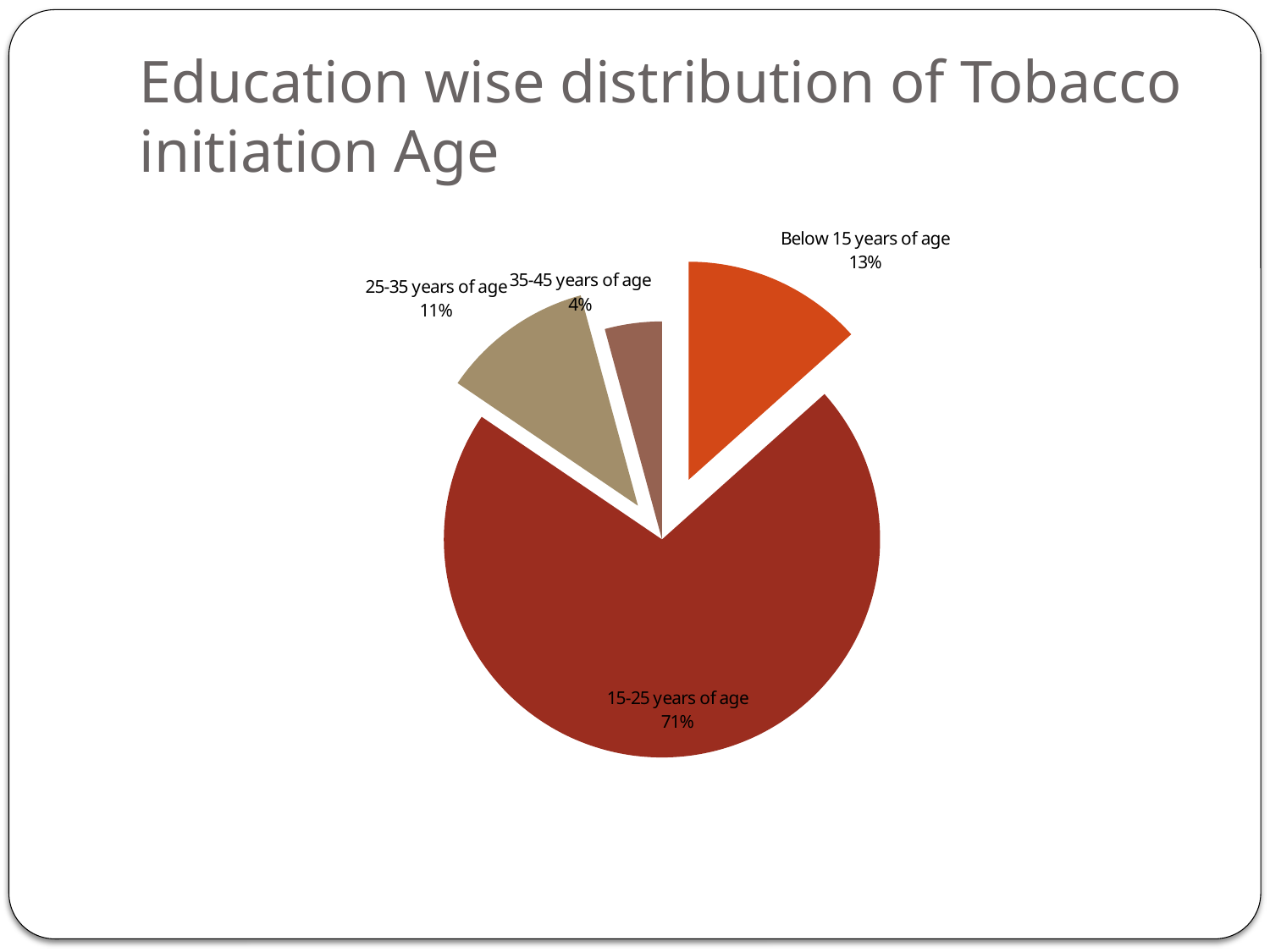
Which age group has the smallest slice of the pie? 35-45 years of age What is the title of the slide? Education wise distribution of Tobacco initiation Age What is the difference in percentage points between the 25-35 years of age slice and the 35-45 years of age slice? 7 Which age group has the largest slice of the pie? 15-25 years of age What share of the pie is the 15-25 years of age slice? 71% How many slices does the pie chart have? 4 What is the difference in percentage points between the 15-25 years of age slice and the Below 15 years of age slice? 58 What share of the pie is the 35-45 years of age slice? 4% Which slice is larger: Below 15 years of age or 25-35 years of age? Below 15 years of age What share of the pie is the 25-35 years of age slice? 11% What kind of chart is shown on the slide? Pie chart